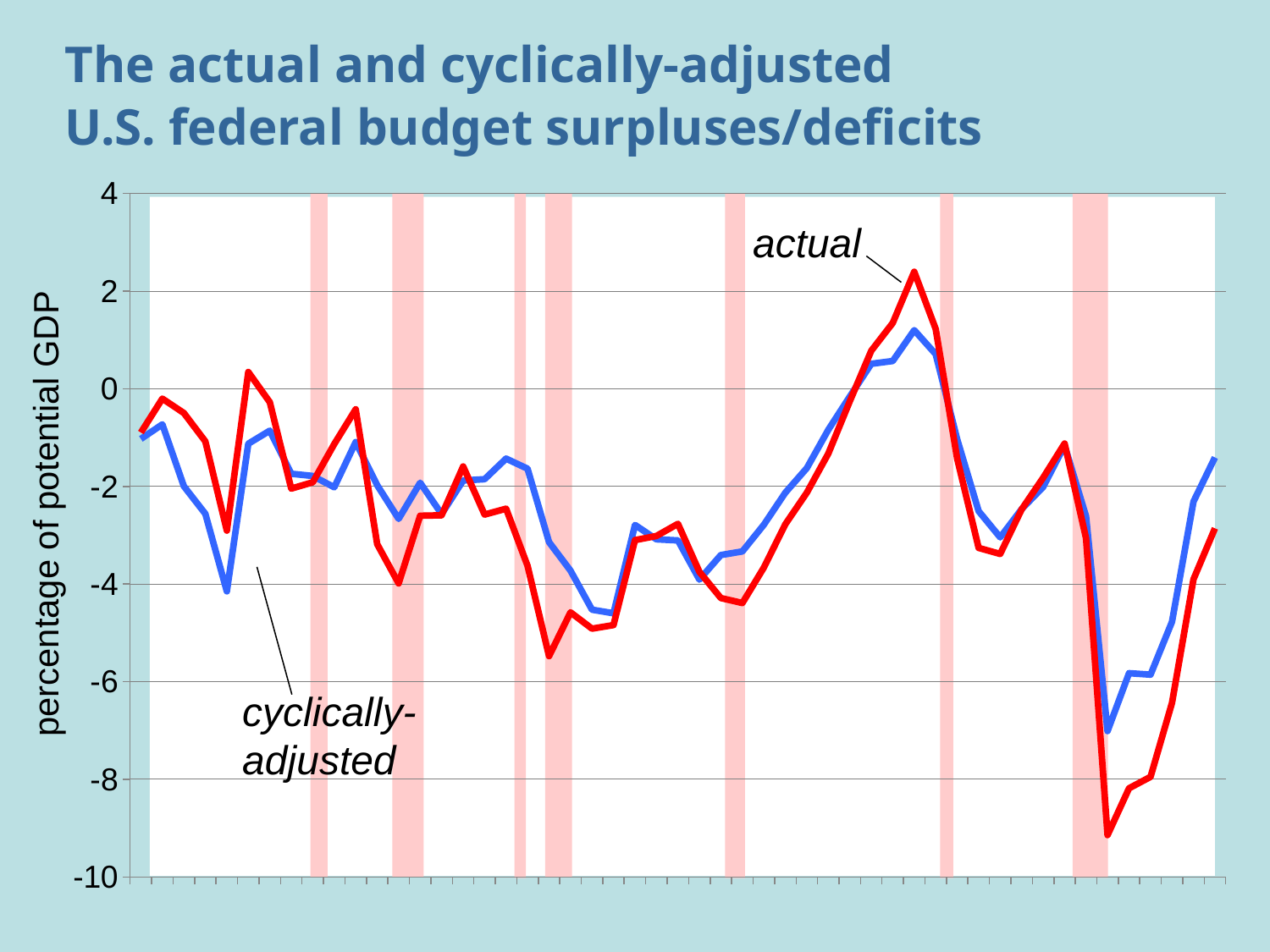
How many series are plotted on the chart? 2 Is the lowest point of the actual line greater or less than -8? less What is the title of the chart on the slide? The actual and cyclically-adjusted U.S. federal budget surpluses/deficits Is the highest point of the actual line greater or less than 2? greater Is the highest point of the cyclically-adjusted line greater or less than 2? less At the far right end of the chart, are both lines rising or falling? rising Which series reaches the lower minimum value, actual or cyclically-adjusted? actual Which series reaches the higher maximum value, actual or cyclically-adjusted? actual What is the label on the vertical axis of the chart? percentage of potential GDP What kind of chart is shown on the slide? line chart